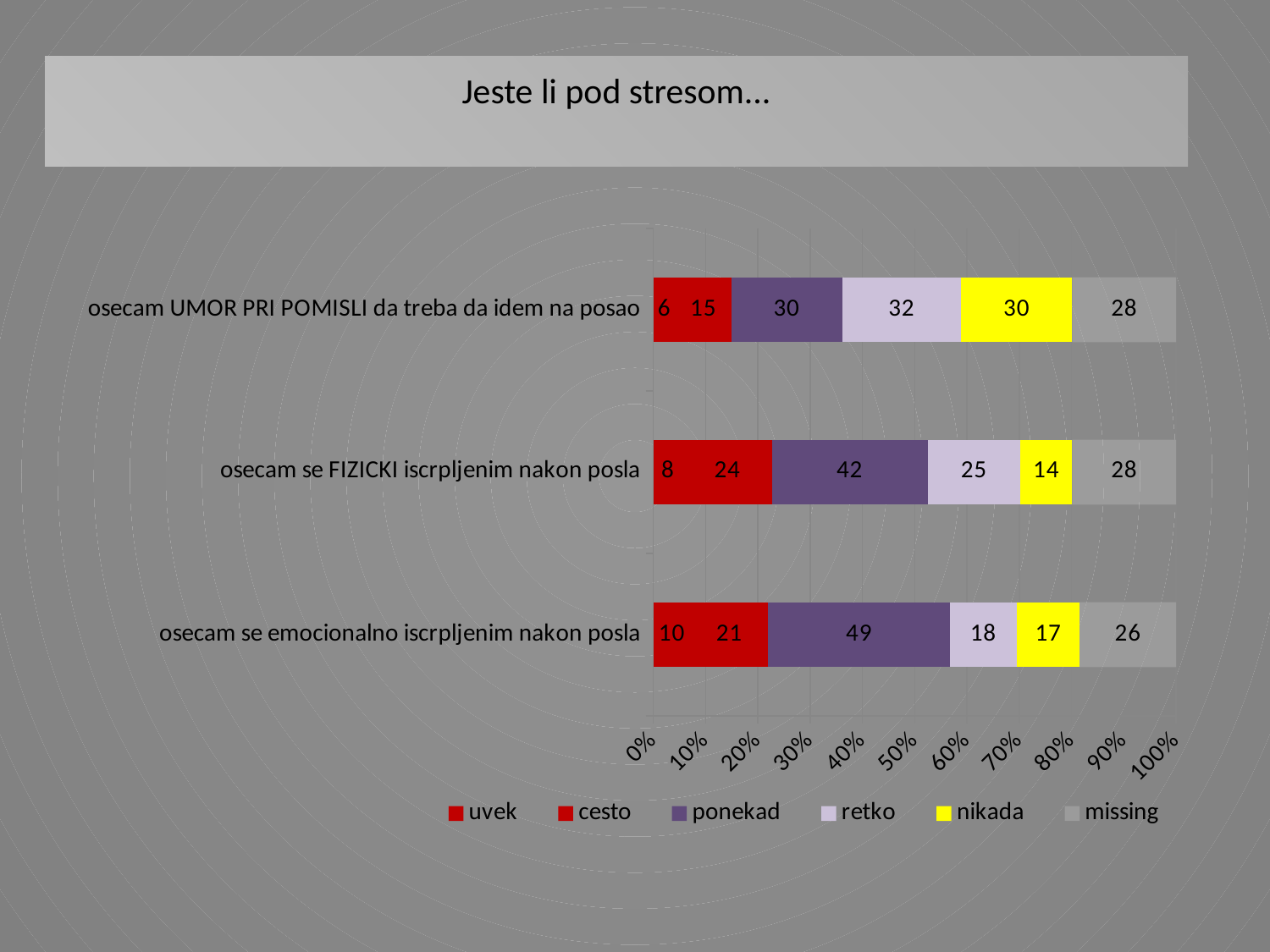
What is the total of all segments in the bar for 'osecam se FIZICKI iscrpljenim nakon posla'? 141 What is the 'nikada' value for 'osecam UMOR PRI POMISLI da treba da idem na posao'? 30 What is the 'cesto' value for 'osecam se FIZICKI iscrpljenim nakon posla'? 24 What kind of chart is shown on the slide? Stacked bar chart How many series does the legend list? 6 What is the title of the chart? Jeste li pod stresom… What is the difference between the 'retko' values for 'osecam UMOR PRI POMISLI da treba da idem na posao' and 'osecam se emocionalno iscrpljenim nakon posla'? 14 Which category has the highest 'ponekad' value? osecam se emocionalno iscrpljenim nakon posla Which is larger: the 'nikada' value for 'osecam se FIZICKI iscrpljenim nakon posla' or for 'osecam se emocionalno iscrpljenim nakon posla'? osecam se emocionalno iscrpljenim nakon posla What is the 'ponekad' value for 'osecam se emocionalno iscrpljenim nakon posla'? 49 Which category has the lowest 'uvek' value? osecam UMOR PRI POMISLI da treba da idem na posao How many categories (bars) are shown in the chart? 3